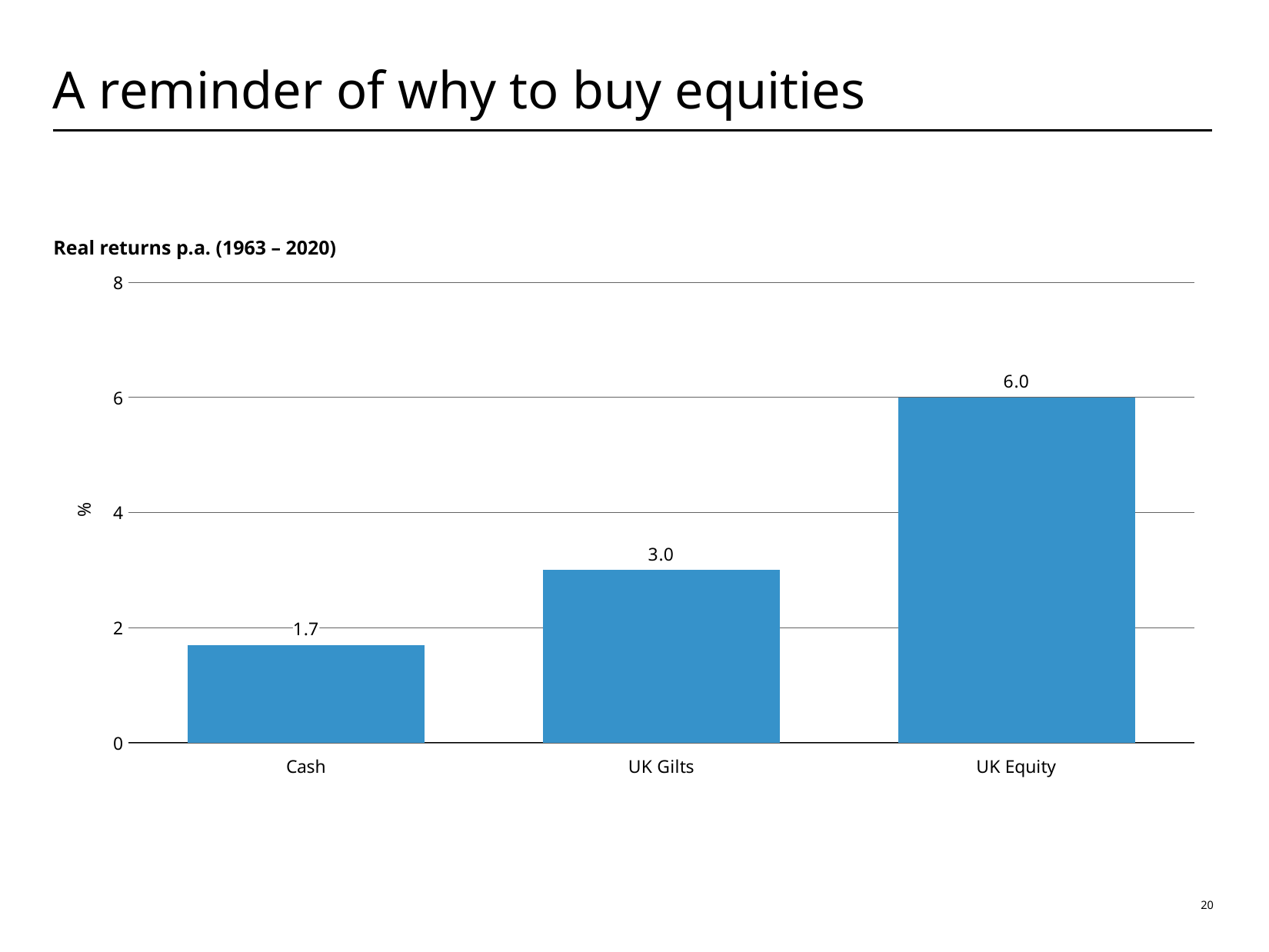
What is the real return p.a. for UK Gilts? 3.0 Which category has the highest real return p.a.? UK Equity Which category has the lowest real return p.a.? Cash What is the title of the chart? Real returns p.a. (1963 – 2020) Is the value for Cash greater or less than 2? less What kind of chart is shown on the slide? Bar chart What is the difference between the real return for UK Equity and UK Gilts? 3.0 What is the difference between the real return for UK Gilts and Cash? 1.3 How many categories are shown in the chart? 3 What is the real return p.a. for Cash? 1.7 Which has a higher real return p.a., Cash or UK Gilts? UK Gilts What is the real return p.a. for UK Equity? 6.0